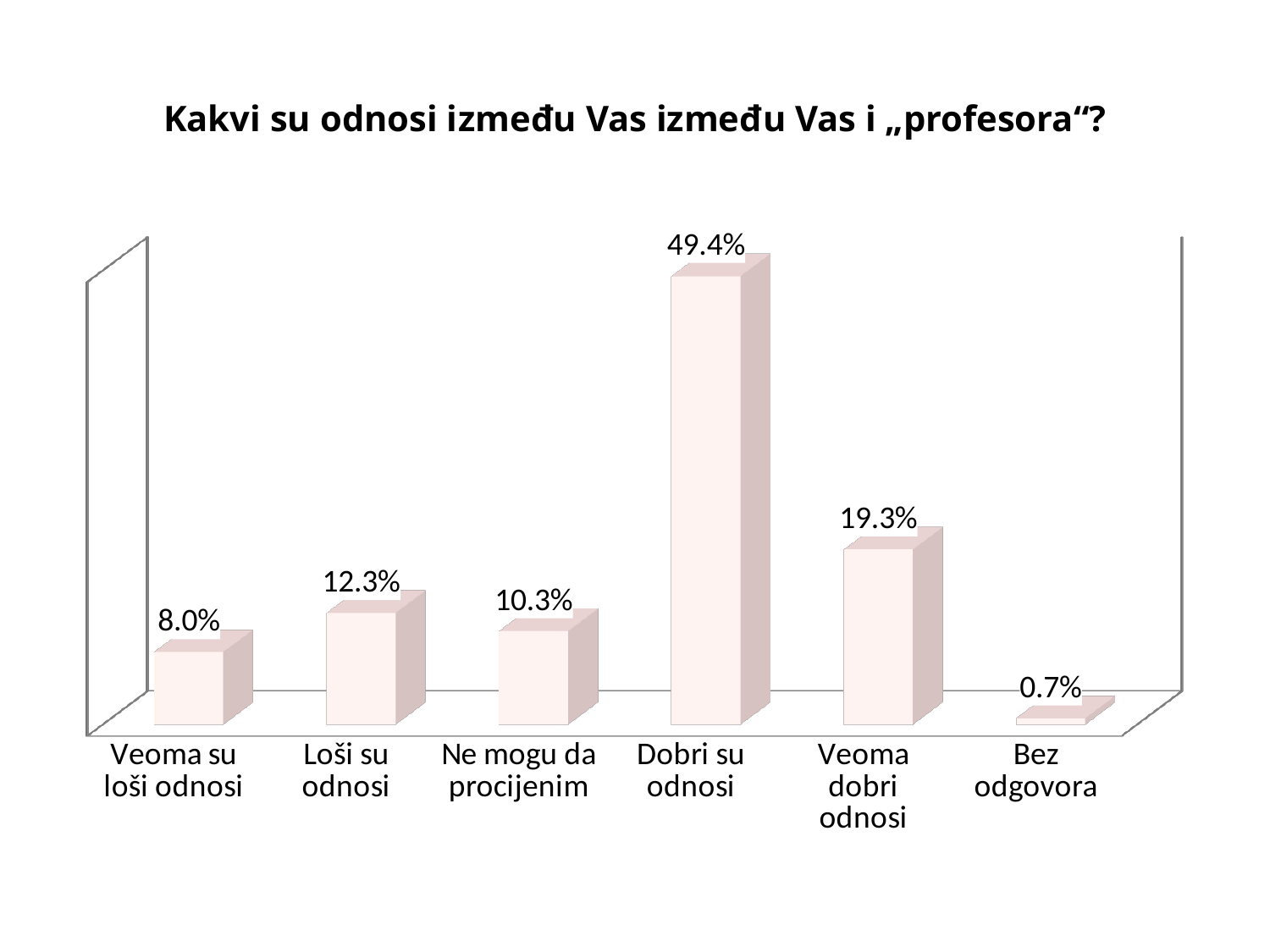
Which category has the highest value? Dobri su odnosi What is the difference between the values for "Dobri su odnosi" and "Veoma dobri odnosi"? 30.1% What is the value for "Bez odgovora"? 0.7% What kind of chart is shown on the slide? Bar chart Which category has the lowest value? Bez odgovora What is the difference between the values for "Loši su odnosi" and "Veoma su loši odnosi"? 4.3% What is the value for "Ne mogu da procijenim"? 10.3% What is the value for "Veoma su loši odnosi"? 8.0% How many categories are shown in the chart? 6 What is the value for "Dobri su odnosi"? 49.4% Which is larger, the value for "Loši su odnosi" or the value for "Ne mogu da procijenim"? Loši su odnosi What is the title of the chart? Kakvi su odnosi između Vas između Vas i „profesora“?